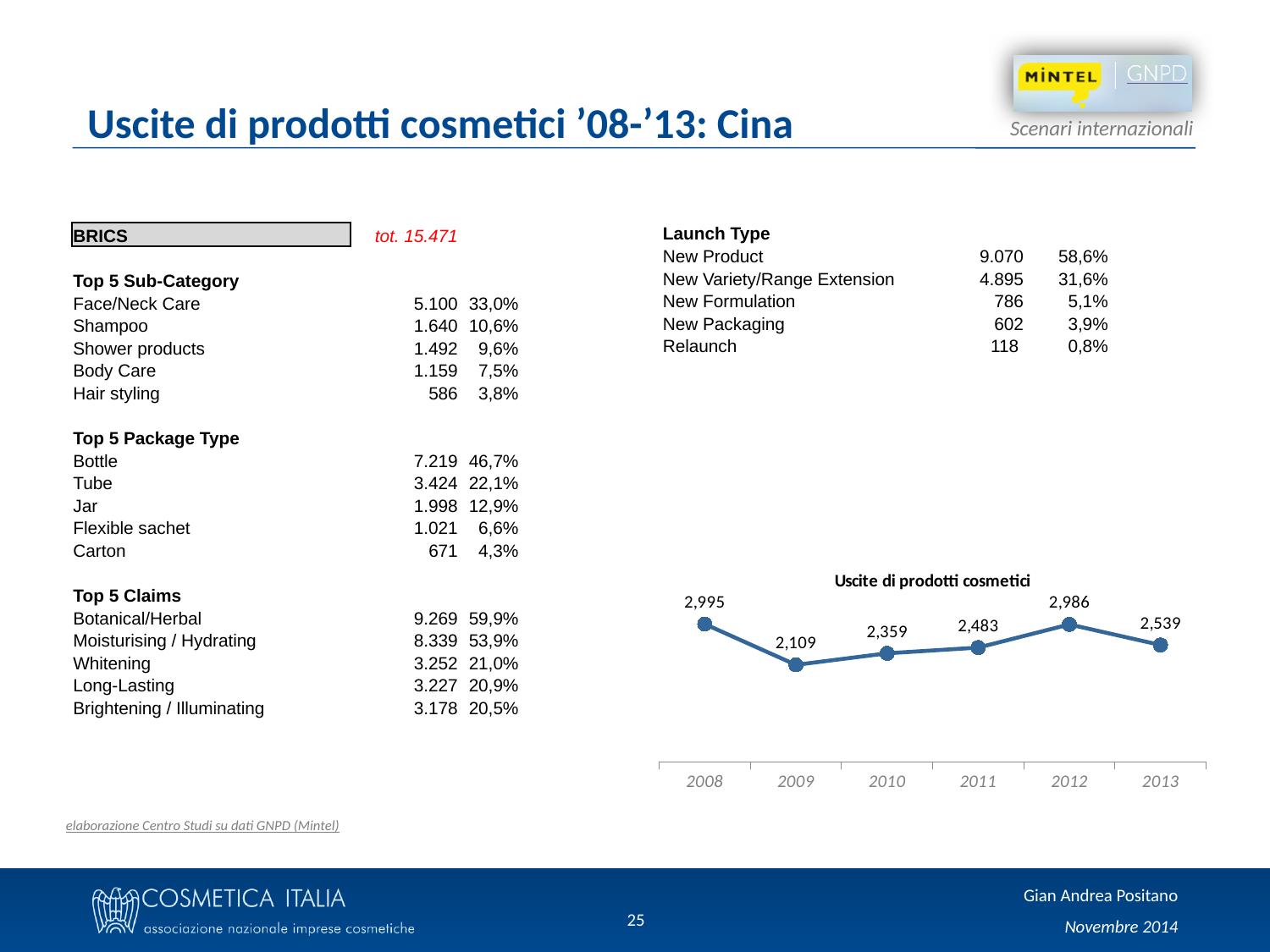
What kind of chart is shown on the slide? Line chart What is the value for 2008 in the chart? 2,995 What is the difference between the values for 2012 and 2013? 447 Which is larger, the value for 2009 or the value for 2013? 2013 What is the value for 2013 in the chart? 2,539 Which year has the lowest value in the chart? 2009 How many data points are plotted in the chart? 6 What is the value for 2011 in the chart? 2,483 What is the title of the chart? Uscite di prodotti cosmetici What is the difference between the values for 2010 and 2009? 250 Which is larger, the value for 2010 or the value for 2011? 2011 Do the values rise or fall from 2009 to 2012? Rise